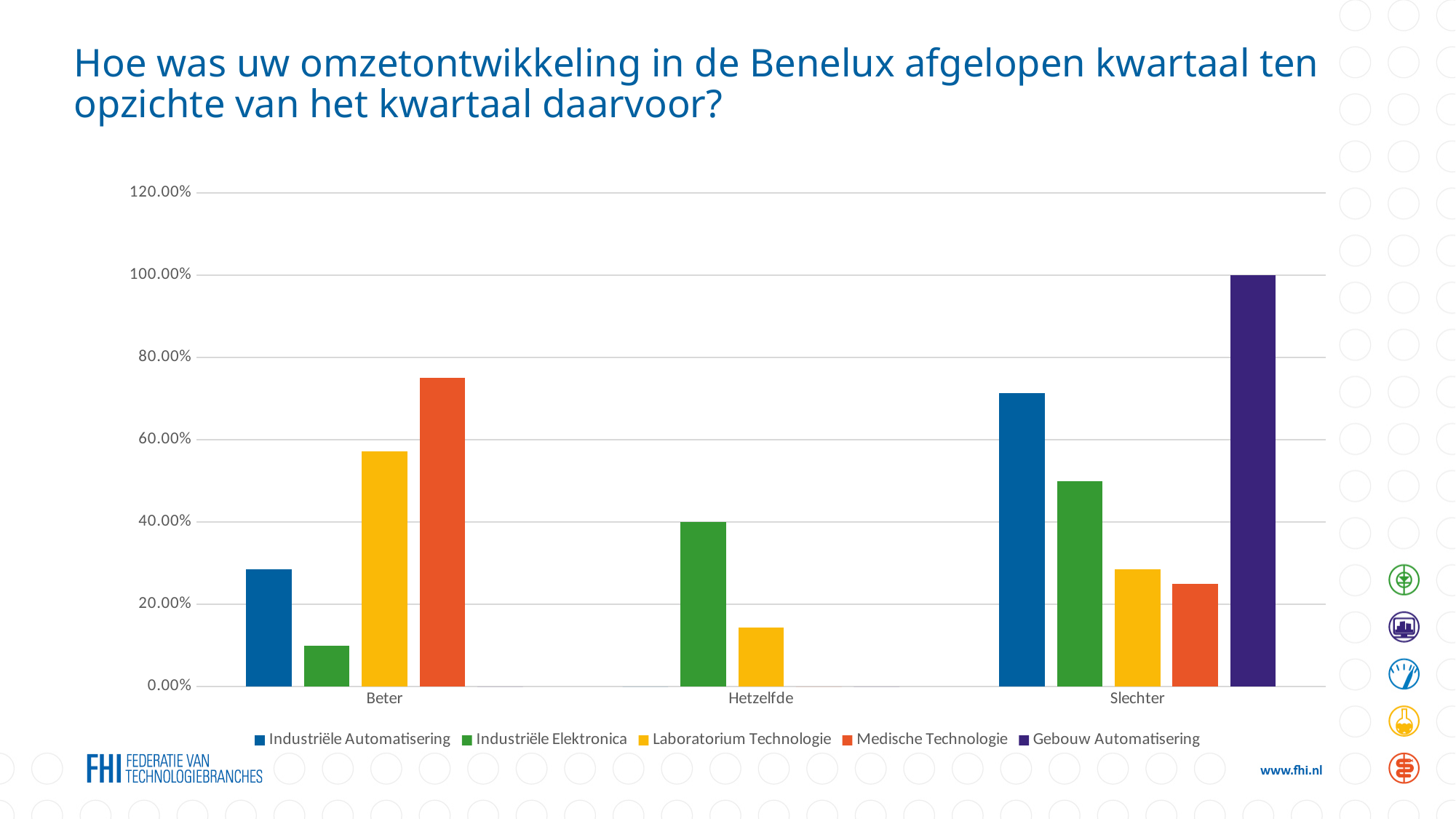
What is the value for Gebouw Automatisering in the Slechter category? 100.00% Which series is shown in purple in the legend? Gebouw Automatisering Is the value for Medische Technologie in the Beter category greater or less than 60.00%? greater What is the value for Industriële Elektronica in the Hetzelfde category? 40.00% Is the value for Laboratorium Technologie in the Hetzelfde category greater or less than 20.00%? less Which series has the highest value in the Beter category? Medische Technologie Which series has the highest value in the Slechter category? Gebouw Automatisering How many series does the legend list? 5 How many categories are shown on the x axis? 3 Which is larger: Industriële Automatisering in Beter or Industriële Automatisering in Slechter? Industriële Automatisering in Slechter What kind of chart is shown on the slide? bar chart